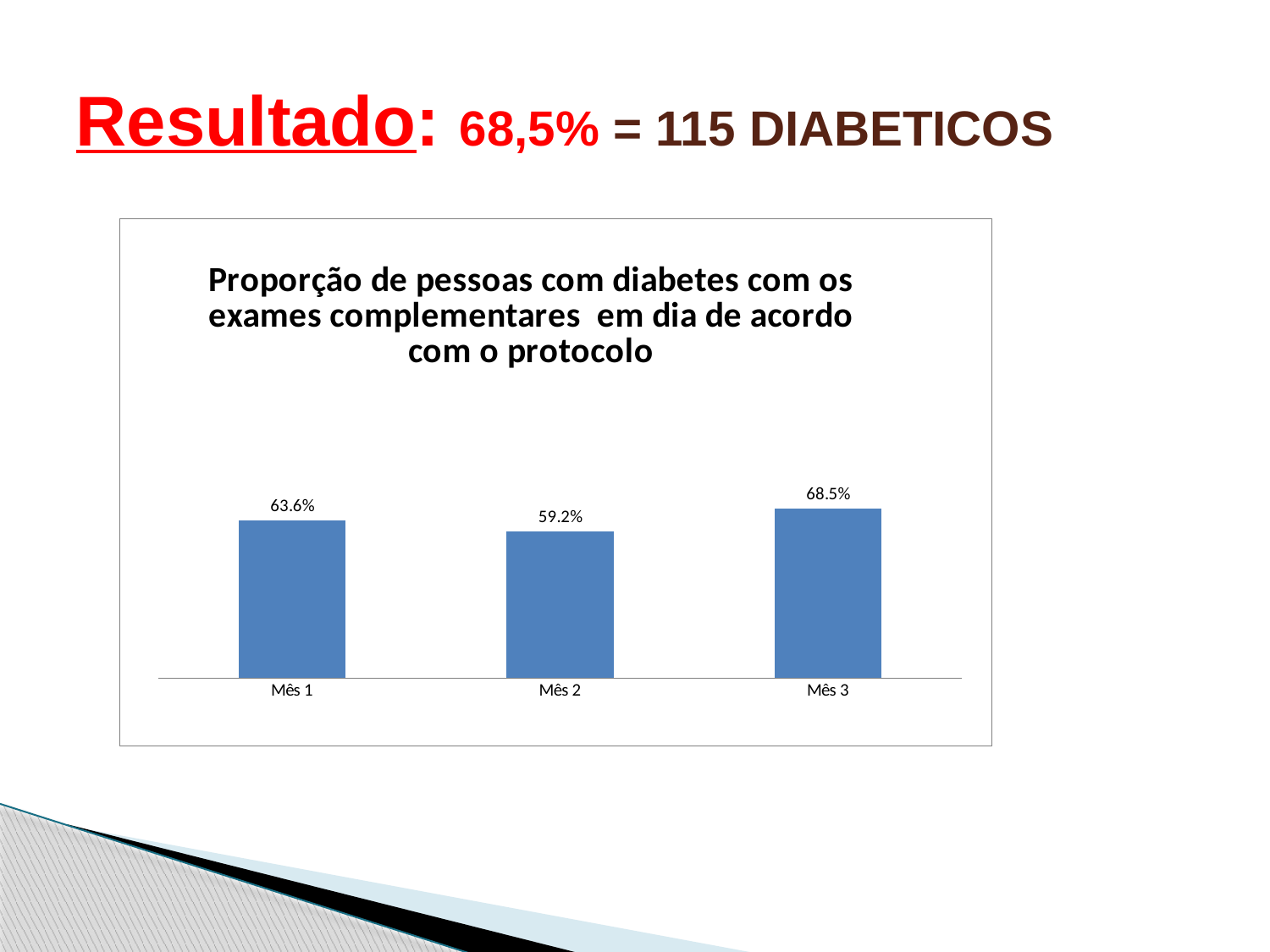
Does the value rise or fall from Mês 2 to Mês 3? Rise What is the value for Mês 1? 63.6% Which month has the highest value? Mês 3 What is the title of the chart? Proporção de pessoas com diabetes com os exames complementares em dia de acordo com o protocolo What is the difference between the values for Mês 1 and Mês 2? 4.4 percentage points What is the difference between the values for Mês 3 and Mês 1? 4.9 percentage points Which month has the lowest value? Mês 2 What is the value for Mês 2? 59.2% Which is larger, the value for Mês 1 or the value for Mês 2? Mês 1 What is the value for Mês 3? 68.5% How many months are shown on the chart? 3 What kind of chart is shown on the slide? Bar chart